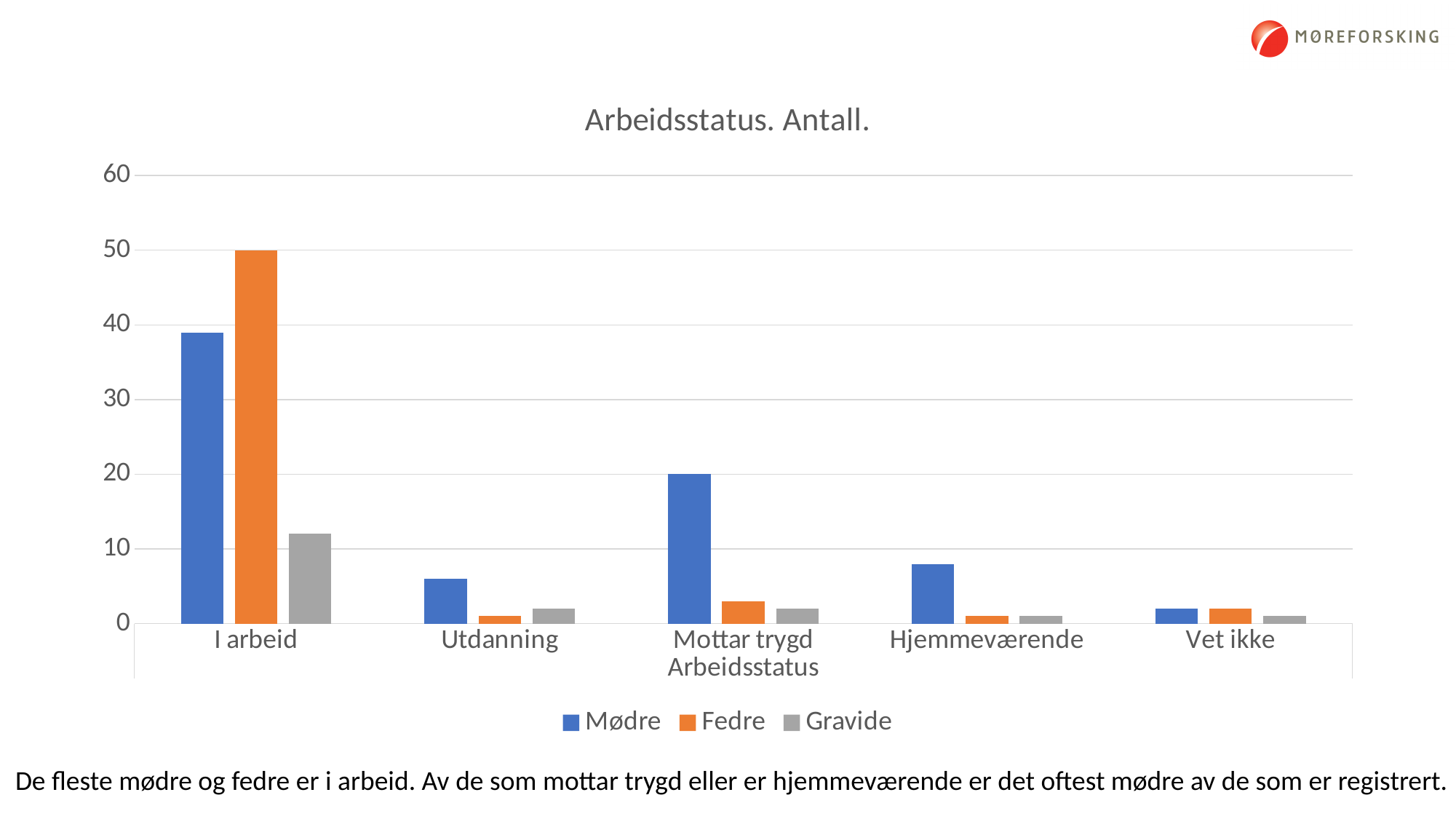
How many series does the legend list? 3 Which series is shown in orange in the legend? Fedre Which series has the highest value in the I arbeid category? Fedre Which category has the highest value for Mødre? I arbeid How many categories are shown on the x axis? 5 What kind of chart is shown on the slide? bar chart What is the value for Fedre in the I arbeid category? 50 What is the title of the chart? Arbeidsstatus. Antall. Is the value for Mødre in the I arbeid category greater or less than 40? less What is the value for Mødre in the Mottar trygd category? 20 Is the value for Gravide in the I arbeid category greater or less than 10? greater In the Hjemmeværende category, which is larger, Mødre or Fedre? Mødre